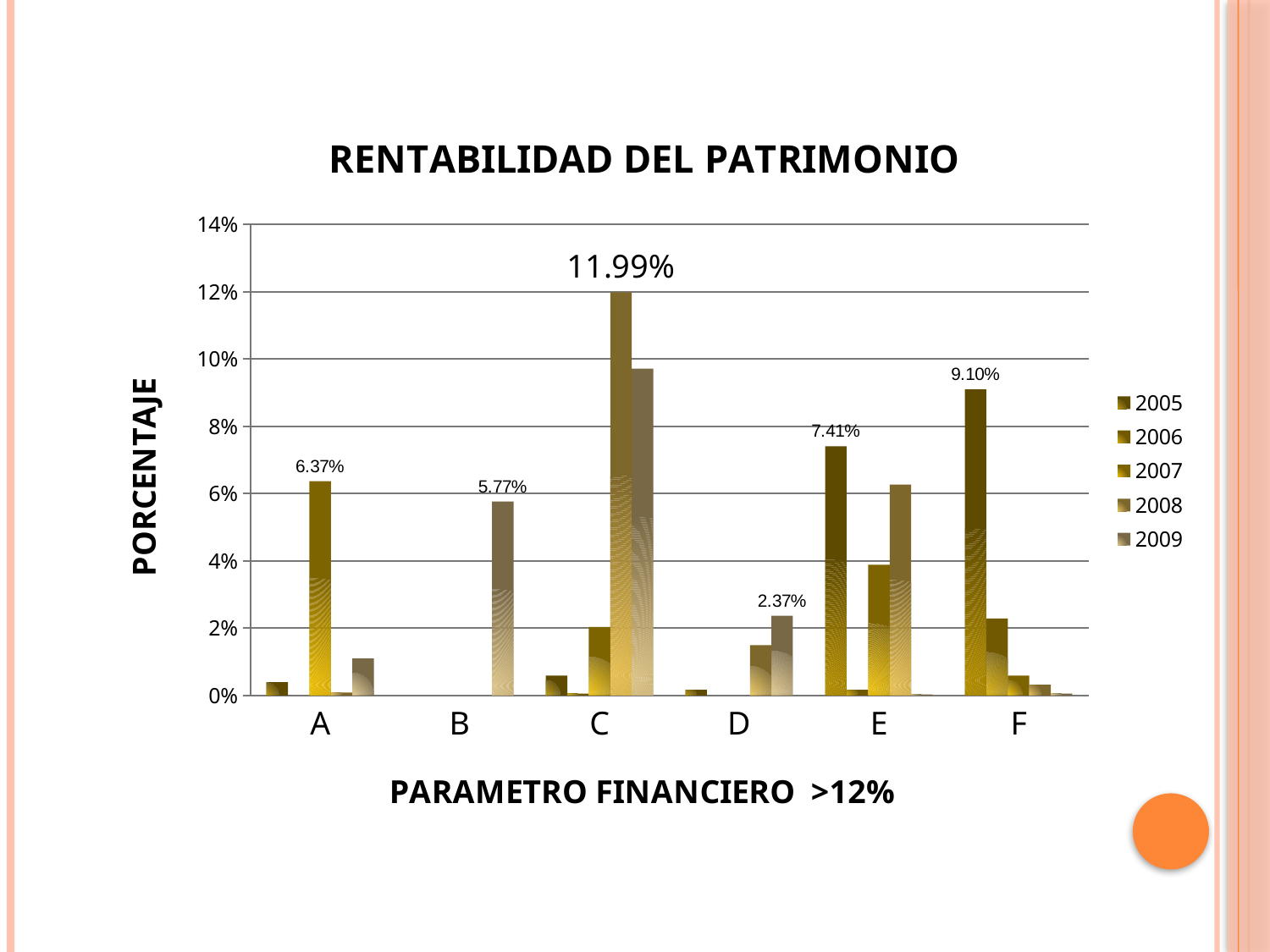
What is the title of the chart? RENTABILIDAD DEL PATRIMONIO How many series does the legend list? 5 What type of chart is shown on the slide? bar chart How many categories are shown on the x axis? 6 What is the labeled value for 2005 in category F? 9.10% Is the value for 2009 in category C greater or less than 8%? greater What is the highest labeled value in category C? 11.99% What is the difference between the labeled value 11.99% in category C and the labeled value 9.10% in category F? 2.89% Which category contains the highest bar in the chart? C What is the labeled value for 2009 in category D? 2.37%